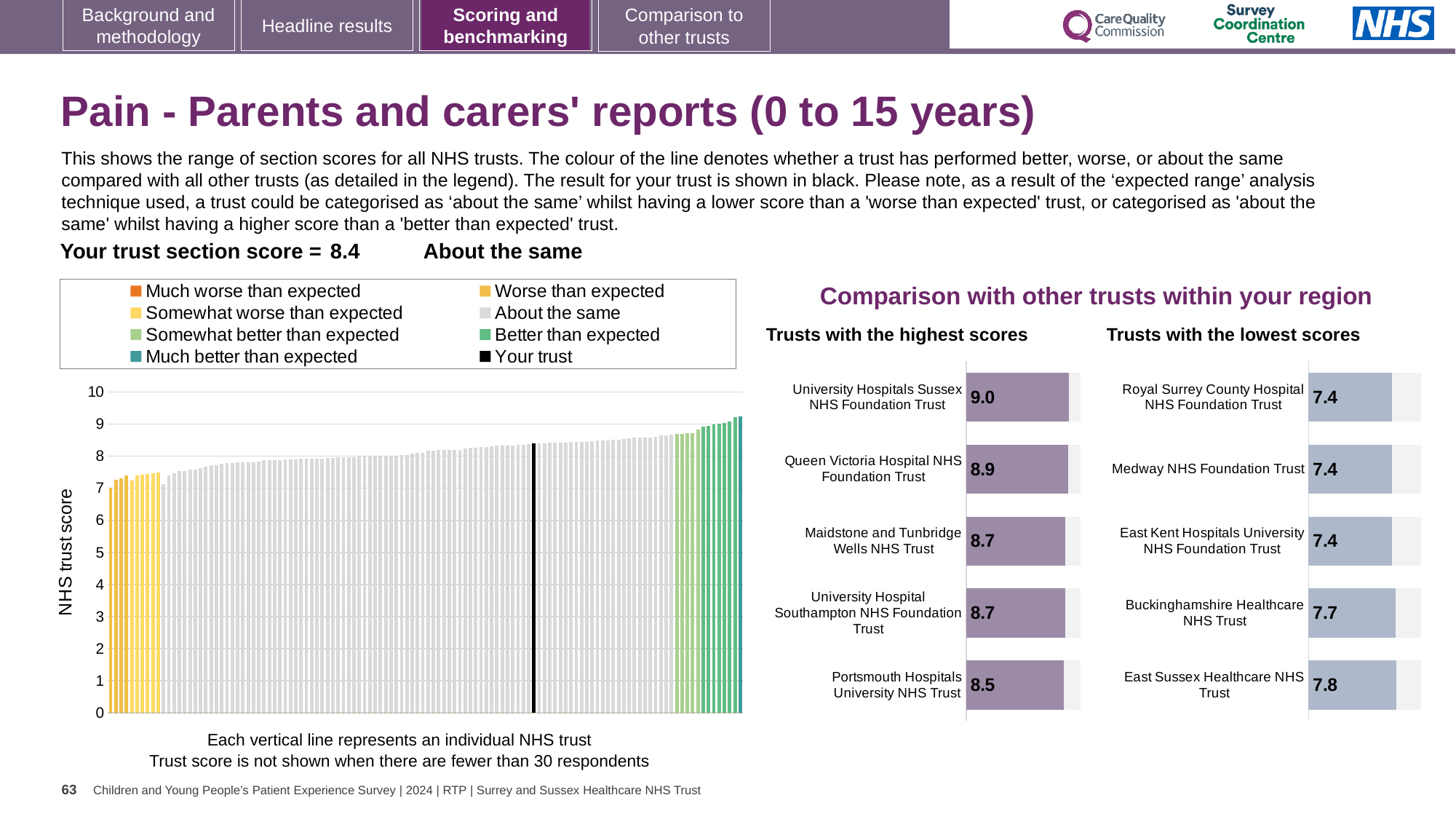
In the 'Trusts with the highest scores' chart, what is the difference between the scores of University Hospitals Sussex NHS Foundation Trust and Portsmouth Hospitals University NHS Trust? 0.5 In the main 'NHS trust score' chart on the left, what is the section score for your trust (the black line)? 8.4 In the 'Trusts with the highest scores' chart, what is the score for University Hospitals Sussex NHS Foundation Trust? 9.0 In the 'Trusts with the lowest scores' chart, which trust has the highest score shown? East Sussex Healthcare NHS Trust In the 'Trusts with the highest scores' chart, which has the larger score: Queen Victoria Hospital NHS Foundation Trust or Maidstone and Tunbridge Wells NHS Trust? Queen Victoria Hospital NHS Foundation Trust How many entries does the legend of the main 'NHS trust score' chart list? 8 In the 'Trusts with the highest scores' chart, which trust has the highest score? University Hospitals Sussex NHS Foundation Trust How many trusts are shown in the 'Trusts with the lowest scores' chart? 5 In the 'Trusts with the highest scores' chart, what is the score for Portsmouth Hospitals University NHS Trust? 8.5 In the main 'NHS trust score' chart on the left, do the trust scores rise or fall from left to right? rise In the 'Trusts with the lowest scores' chart, what is the score for East Sussex Healthcare NHS Trust? 7.8 In the 'Trusts with the lowest scores' chart, what is the score for Buckinghamshire Healthcare NHS Trust? 7.7